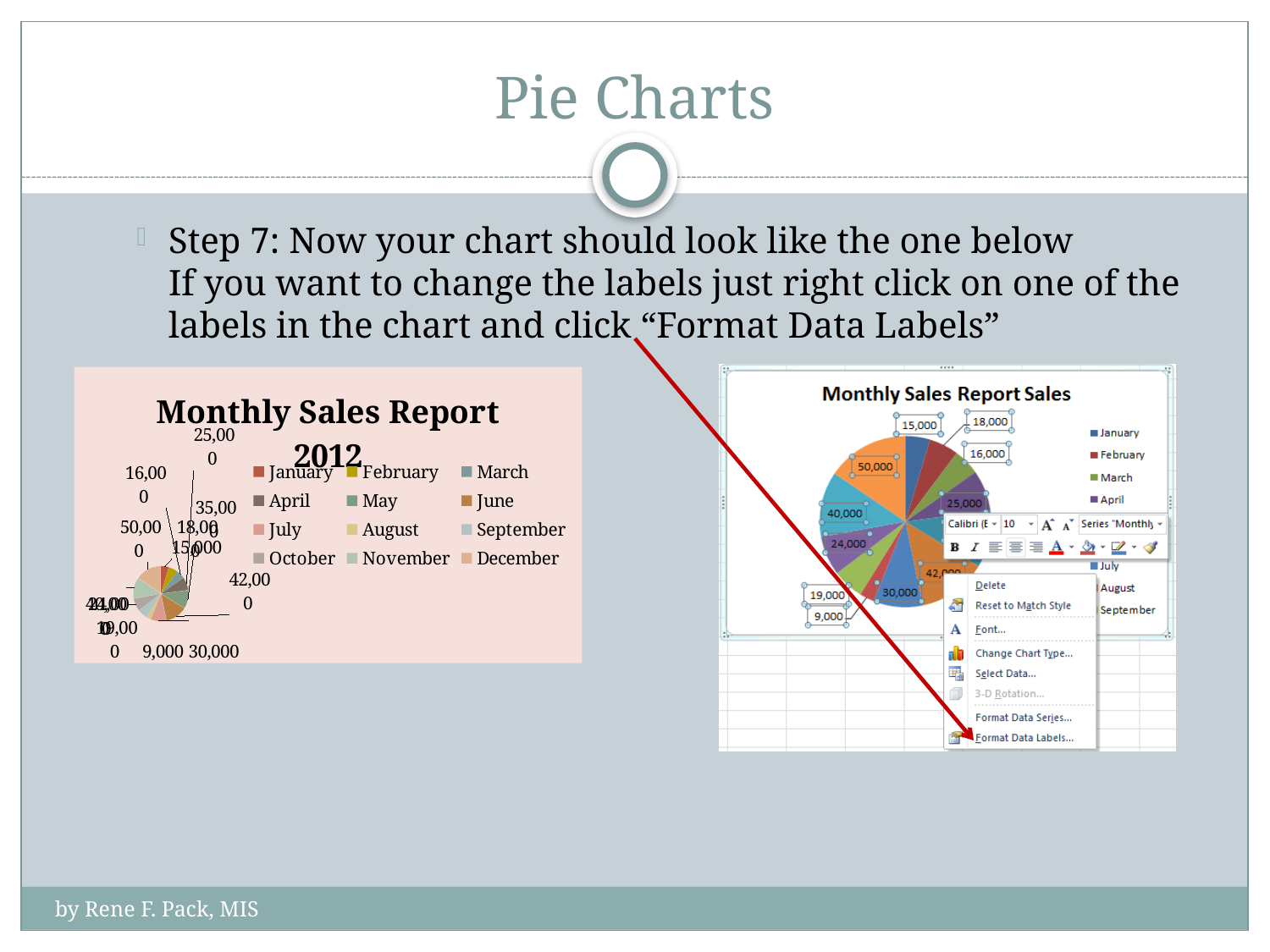
What kind of chart is the chart titled "Monthly Sales Report 2012" on the left of the slide? pie chart In the right-hand chart "Monthly Sales Report Sales", what is the largest data label value shown on the pie? 50,000 What is the title of the chart in the Excel screenshot on the right of the slide? Monthly Sales Report Sales What kind of chart is shown in the Excel screenshot on the right of the slide? pie chart In the right-hand chart "Monthly Sales Report Sales", which is larger: the slice labelled 15,000 or the slice labelled 18,000? 18,000 In the right-hand chart "Monthly Sales Report Sales", which is larger: the slice labelled 42,000 or the slice labelled 40,000? 42,000 In the right-hand chart "Monthly Sales Report Sales", what is the difference between the slices labelled 42,000 and 40,000? 2,000 In the right-hand chart "Monthly Sales Report Sales", what is the smallest data label value shown on the pie? 9,000 In the right-hand chart "Monthly Sales Report Sales", what is the difference between the largest data label (50,000) and the smallest data label (9,000)? 41,000 Which month is the first entry in the legend of the left chart "Monthly Sales Report 2012"? January How many months are listed in the legend of the left chart titled "Monthly Sales Report 2012"? 12